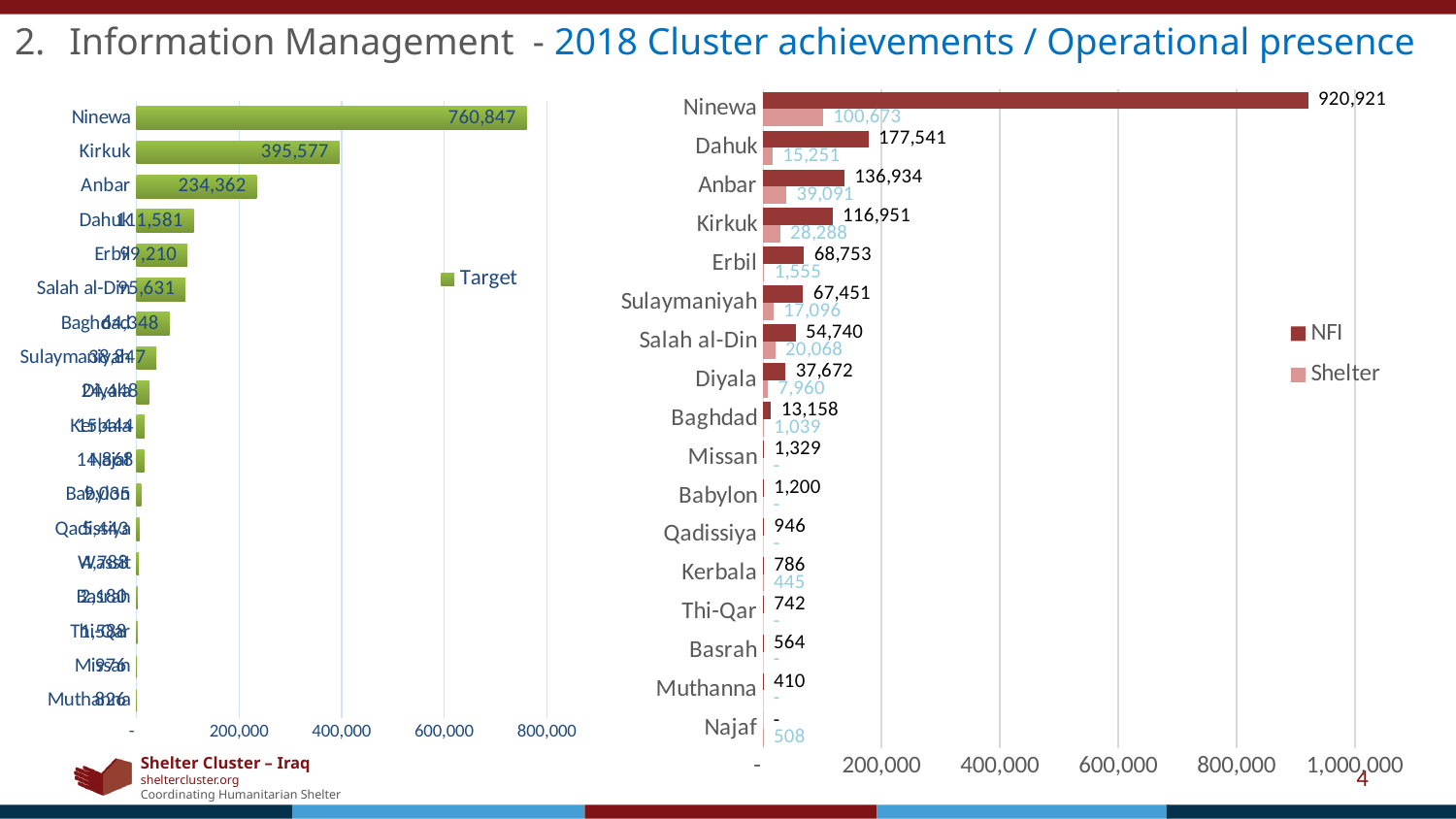
In the left chart, what is the Target value for Ninewa? 760,847 In the right chart, what is the Shelter value for Anbar? 39,091 In the right chart, which is larger, the NFI value for Dahuk or the NFI value for Anbar? Dahuk In the left chart, what is the Target value for Kirkuk? 395,577 In the left chart, what is the Target value for Anbar? 234,362 In the right chart, what is the NFI value for Ninewa? 920,921 In the right chart, which governorate has the highest NFI value? Ninewa How many governorates are shown in the right chart? 17 In the right chart, what is the difference between the NFI and Shelter values for Ninewa? 820,248 What kind of chart is the left chart? Bar chart In the right chart, what is the NFI value for Dahuk? 177,541 How many series does the legend of the right chart list? 2